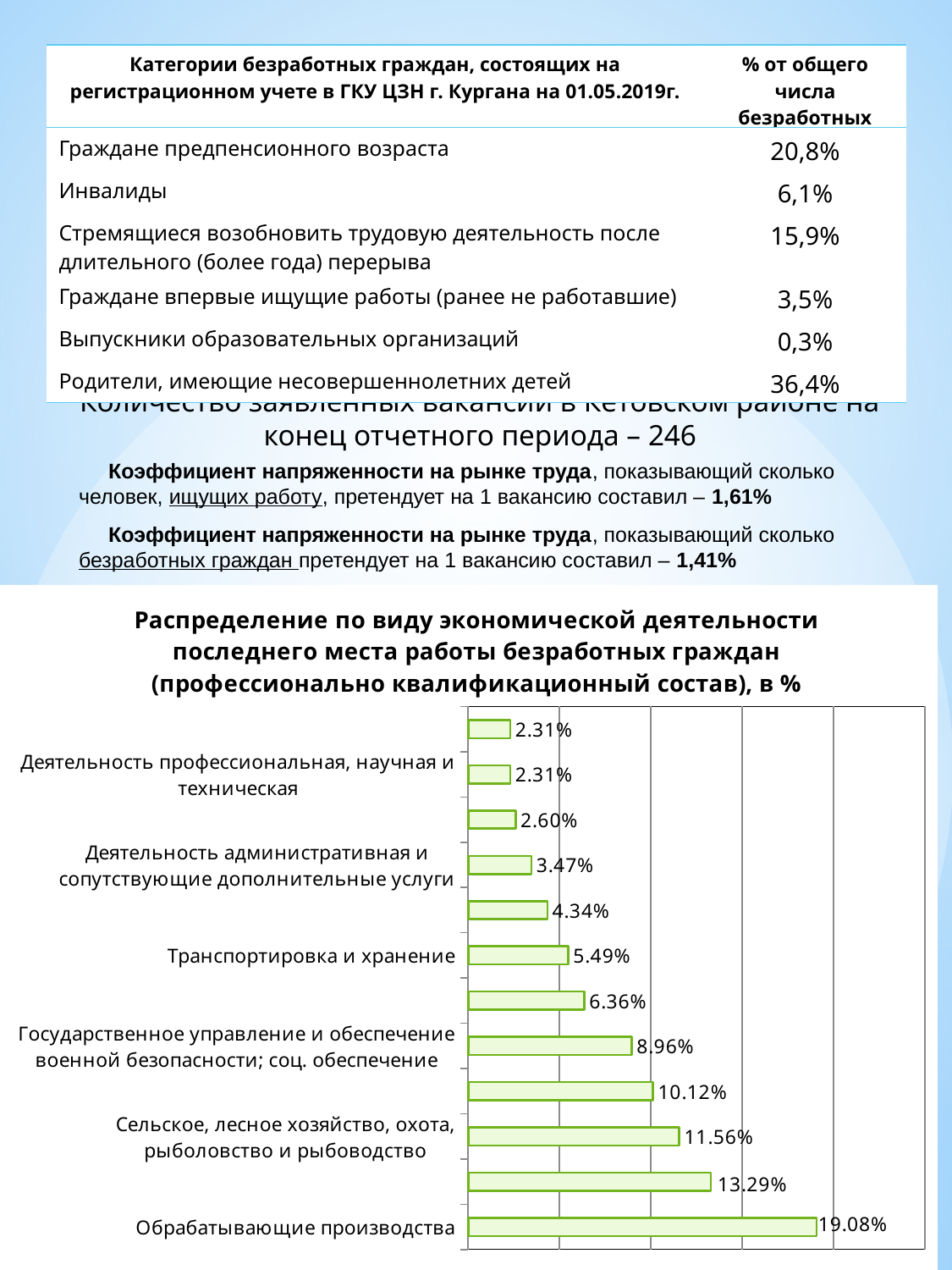
Which category has the highest value in the bar chart? Обрабатывающие производства In the bar chart, what is the value for 'Обрабатывающие производства'? 19.08% In the bar chart, what is the value for 'Сельское, лесное хозяйство, охота, рыболовство и рыбоводство'? 11.56% In the bar chart, what is the value for 'Государственное управление и обеспечение военной безопасности; соц. обеспечение'? 8.96% In the bar chart, what is the value for 'Транспортировка и хранение'? 5.49% In the bar chart, what is the value for 'Деятельность профессиональная, научная и техническая'? 2.31% How many bars are plotted in the bar chart? 12 In the bar chart, which is larger: the value for 'Транспортировка и хранение' or for 'Сельское, лесное хозяйство, охота, рыболовство и рыбоводство'? Сельское, лесное хозяйство, охота, рыболовство и рыбоводство What kind of chart is shown under the title 'Распределение по виду экономической деятельности последнего места работы безработных граждан'? Bar chart In the bar chart, what is the difference between the values for 'Обрабатывающие производства' and 'Сельское, лесное хозяйство, охота, рыболовство и рыбоводство'? 7.52% In the bar chart, what is the value for 'Деятельность административная и сопутствующие дополнительные услуги'? 3.47% What is the smallest value shown on any bar in the bar chart? 2.31%